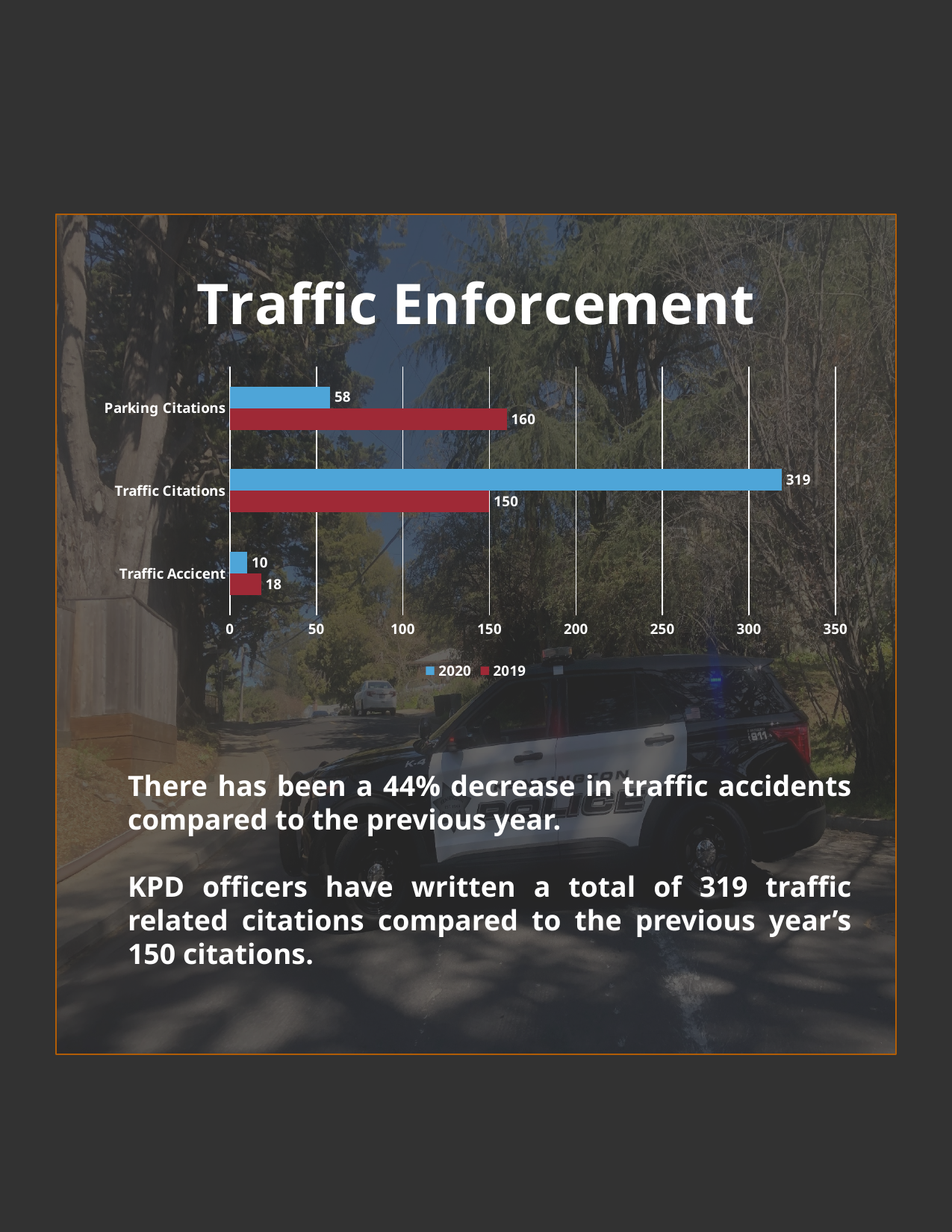
How many categories are shown on the chart? 3 What is the 2020 value for Traffic Accicent? 10 What is the difference between the 2020 and 2019 values for Traffic Citations? 169 Which category has the highest 2020 value? Traffic Citations What is the difference between the 2019 and 2020 values for Parking Citations? 102 What kind of chart is shown on the slide? Bar chart Which category has the lowest 2019 value? Traffic Accicent Which is larger for Parking Citations, the 2020 value or the 2019 value? 2019 How many series does the legend list? 2 What is the 2019 value for Parking Citations? 160 What is the 2019 value for Traffic Citations? 150 What is the 2020 value for Traffic Citations? 319